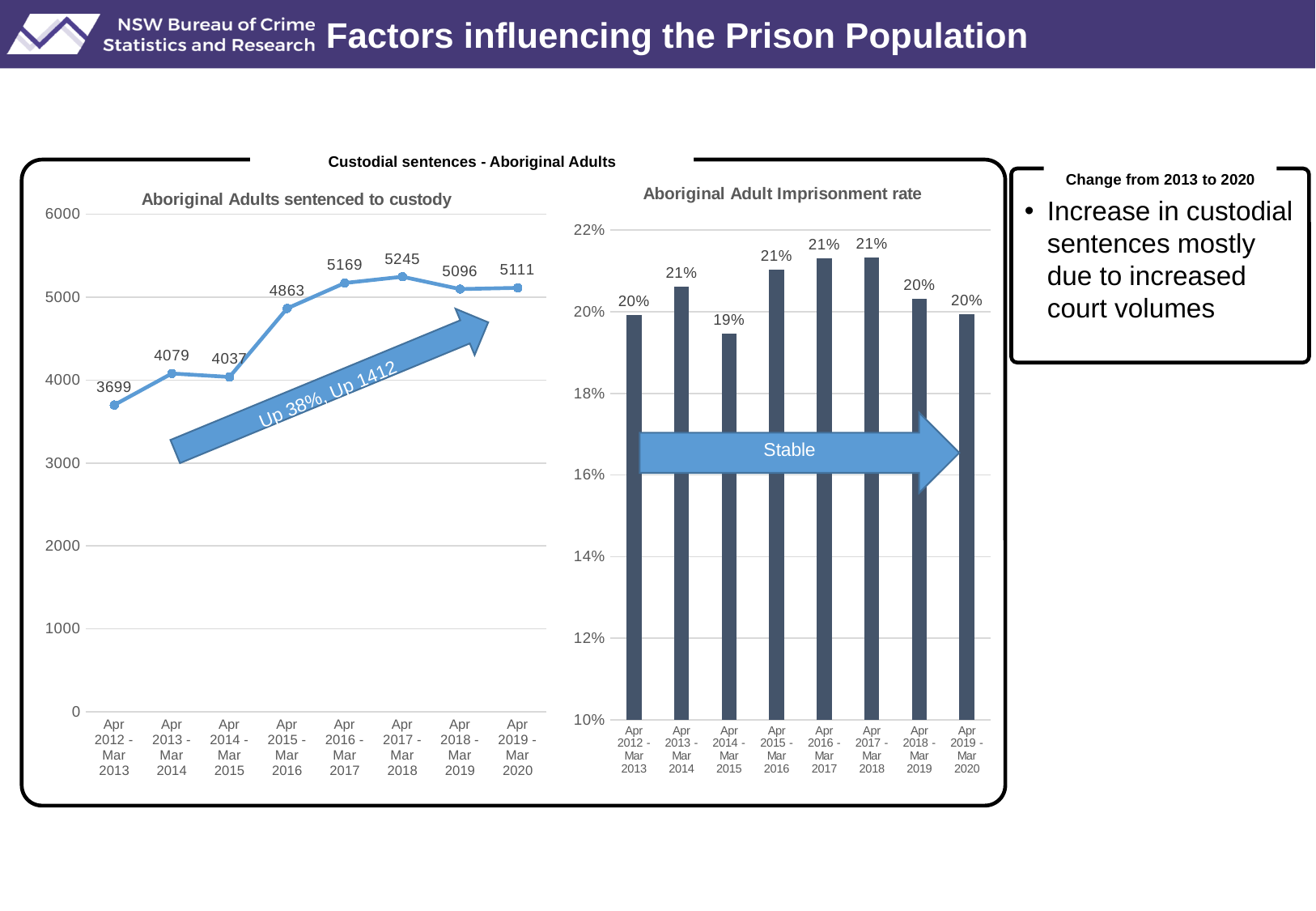
How many periods are plotted in the 'Aboriginal Adults sentenced to custody' chart? 8 What text is written on the arrow in the 'Aboriginal Adult Imprisonment rate' chart? Stable In the 'Aboriginal Adults sentenced to custody' chart, what is the value for Apr 2019 - Mar 2020? 5111 In the 'Aboriginal Adult Imprisonment rate' chart, which period has the lowest value? Apr 2014 - Mar 2015 In the 'Aboriginal Adults sentenced to custody' chart, what is the difference between the values for Apr 2015 - Mar 2016 and Apr 2014 - Mar 2015? 826 In the 'Aboriginal Adults sentenced to custody' chart, what is the value for Apr 2012 - Mar 2013? 3699 What kind of chart is 'Aboriginal Adults sentenced to custody'? Line chart In the 'Aboriginal Adults sentenced to custody' chart, which period has the lowest value? Apr 2012 - Mar 2013 In the 'Aboriginal Adults sentenced to custody' chart, which is larger: the value for Apr 2013 - Mar 2014 or Apr 2014 - Mar 2015? Apr 2013 - Mar 2014 In the 'Aboriginal Adults sentenced to custody' chart, which period has the highest value? Apr 2017 - Mar 2018 What kind of chart is 'Aboriginal Adult Imprisonment rate'? Bar chart In the 'Aboriginal Adult Imprisonment rate' chart, what is the value for Apr 2014 - Mar 2015? 19%